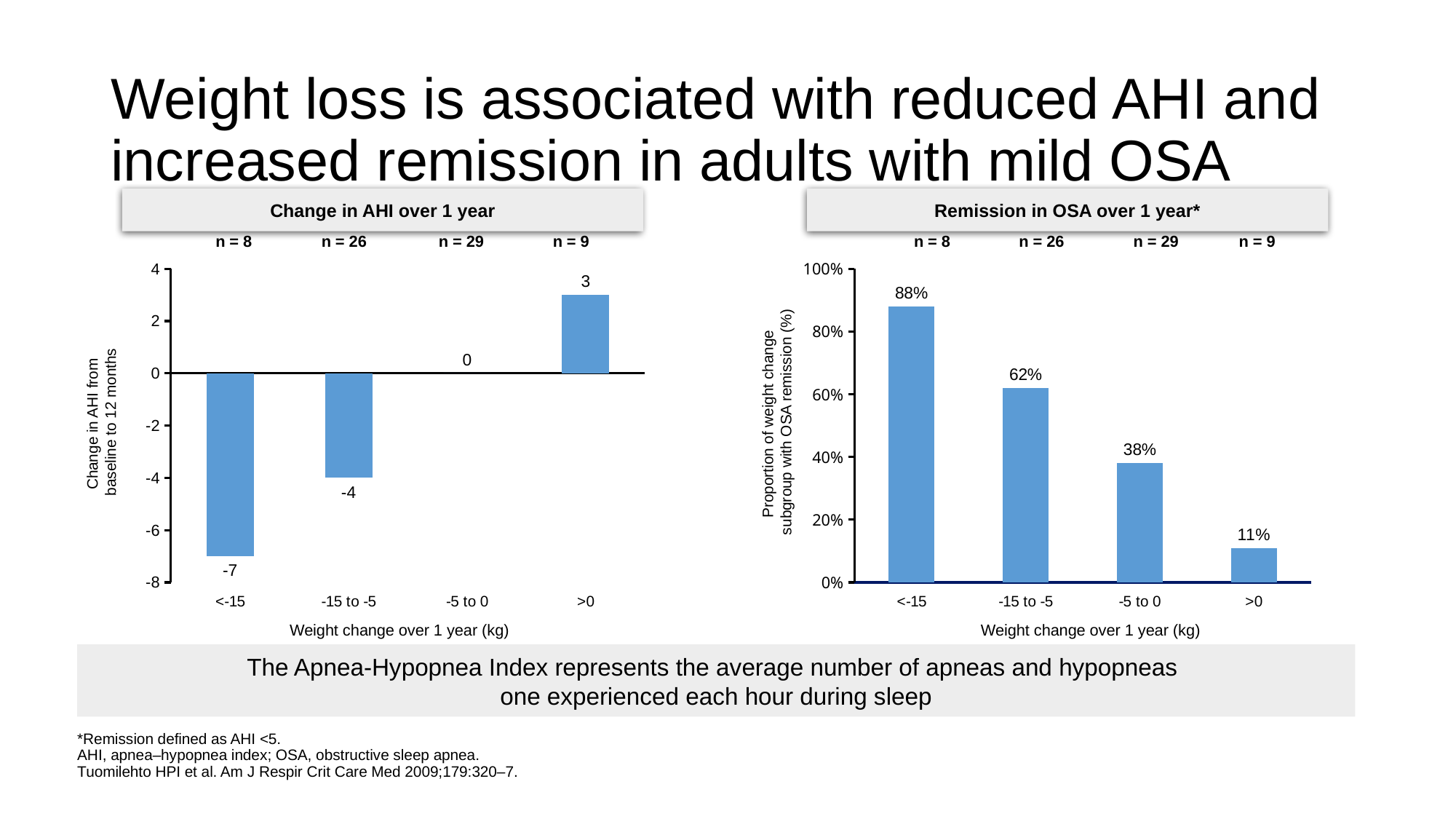
What is the x-axis title of the 'Remission in OSA over 1 year*' chart? Weight change over 1 year (kg) In the 'Change in AHI over 1 year' chart, what is the value for the <-15 kg weight change group? -7 In the 'Change in AHI over 1 year' chart, what is the value for the >0 kg weight change group? 3 In the 'Remission in OSA over 1 year*' chart, what is the difference between the remission proportions for the <-15 group and the >0 group? 77% In the 'Remission in OSA over 1 year*' chart, which weight change group has the highest remission proportion? <-15 In the 'Change in AHI over 1 year' chart, which weight change group has the lowest value? <-15 In the 'Remission in OSA over 1 year*' chart, which is larger: the value for -5 to 0 or the value for >0? -5 to 0 What kind of chart is the 'Remission in OSA over 1 year*' chart? bar chart In the 'Change in AHI over 1 year' chart, how many weight change categories are shown? 4 In the 'Change in AHI over 1 year' chart, what is the difference between the values for the -15 to -5 group and the <-15 group? 3 In the 'Change in AHI over 1 year' chart, do the values rise or fall moving from <-15 to >0 along the x axis? rise In the 'Remission in OSA over 1 year*' chart, what is the remission proportion for the -15 to -5 kg group? 62%